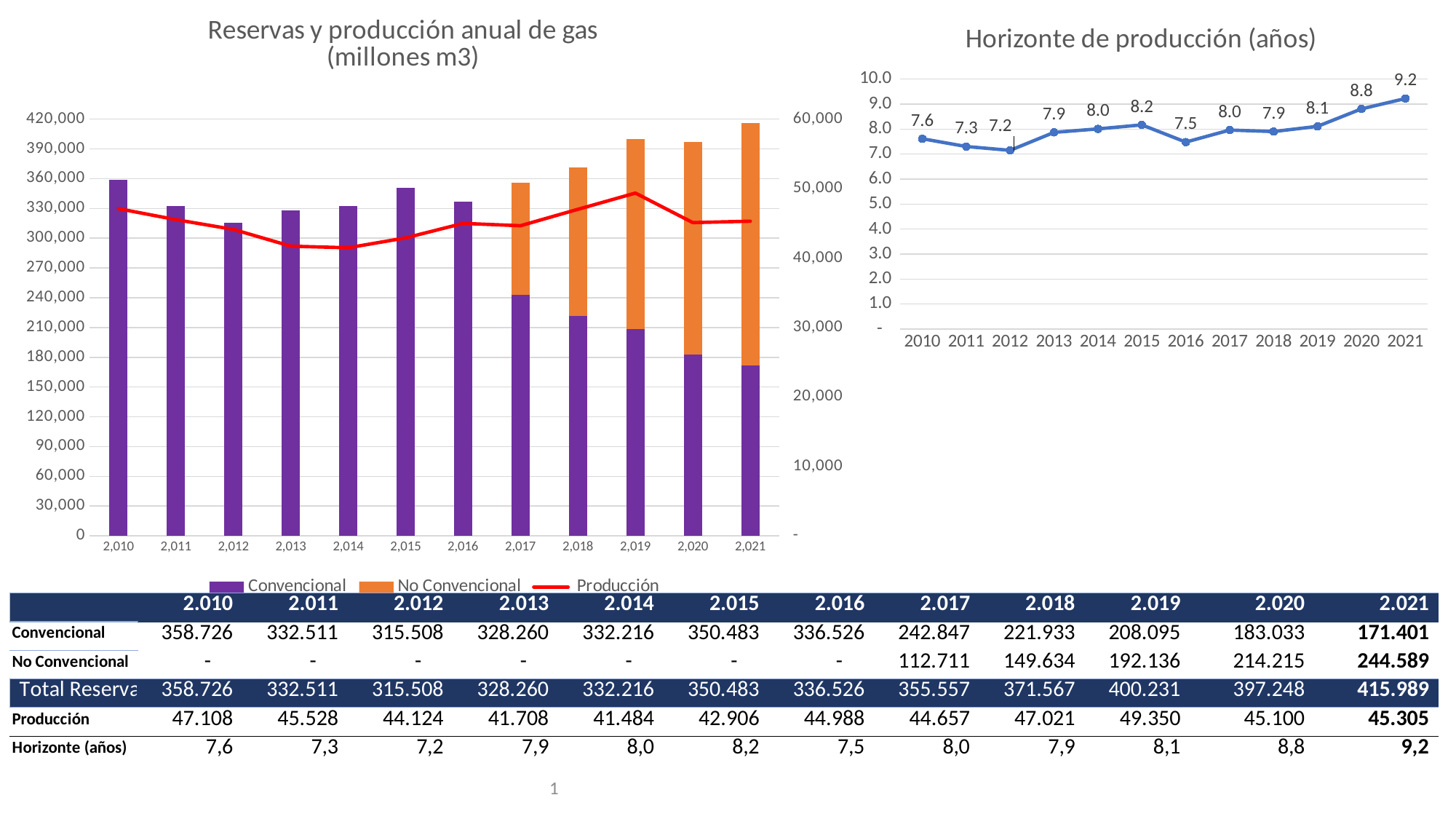
In the 'Reservas y producción anual de gas (millones m3)' chart, is the Convencional value for 2,010 greater or less than 330,000? greater How many years are plotted on the 'Horizonte de producción (años)' chart? 12 In the 'Horizonte de producción (años)' chart, which year has the larger value, 2015 or 2016? 2015 In the 'Horizonte de producción (años)' chart, what is the value for 2021? 9.2 How many series does the legend of the 'Reservas y producción anual de gas (millones m3)' chart list? 3 According to the table below the 'Reservas y producción anual de gas (millones m3)' chart, what is the Convencional value for 2.021? 171.401 In the 'Horizonte de producción (años)' chart, what is the difference between the 2021 value and the 2012 value? 2.0 According to the table below the 'Reservas y producción anual de gas (millones m3)' chart, what is the total reserve (Convencional plus No Convencional) for 2.021? 415.989 In the 'Horizonte de producción (años)' chart, which year has the lowest value? 2012 What kind of chart is the 'Horizonte de producción (años)' chart? line chart In the 'Horizonte de producción (años)' chart, which year has the highest value? 2021 In the 'Horizonte de producción (años)' chart, do the values rise or fall from 2016 to 2021? rise